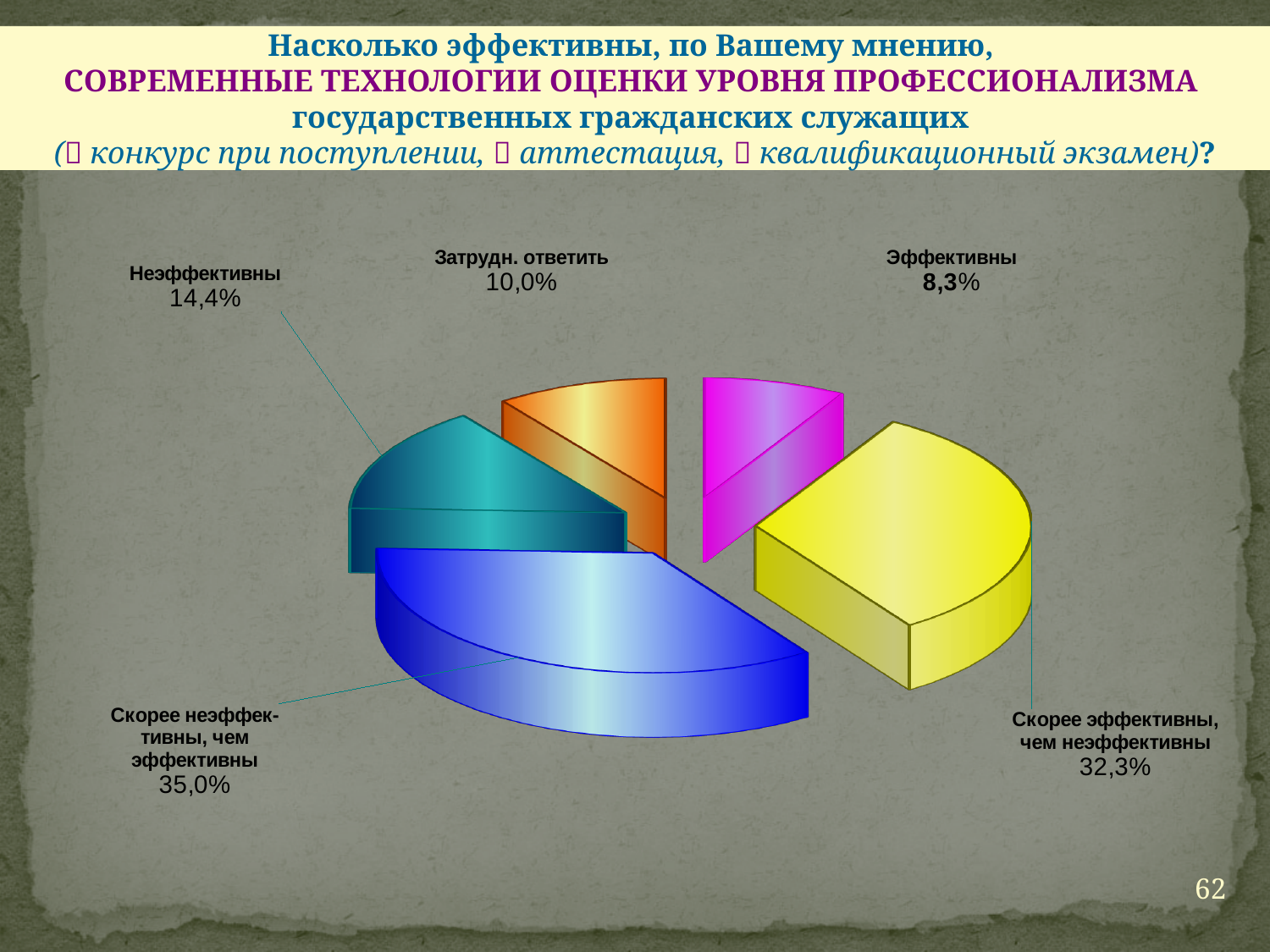
Which answer option has the largest share of the pie? Скорее неэффективны, чем эффективны What share of respondents answered "Неэффективны"? 14,4% How many slices does the pie chart have? 5 What share of respondents answered "Затрудн. ответить"? 10,0% What share of respondents answered "Скорее эффективны, чем неэффективны"? 32,3% Which is larger: the share for "Неэффективны" or the share for "Затрудн. ответить"? Неэффективны What share of respondents answered "Эффективны"? 8,3% What colour is the slice for "Скорее эффективны, чем неэффективны"? yellow What kind of chart is shown on the slide? pie chart What share of respondents answered "Скорее неэффективны, чем эффективны"? 35,0% What is the difference in percentage points between "Скорее неэффективны, чем эффективны" and "Скорее эффективны, чем неэффективны"? 2,7 Which answer option has the smallest share of the pie? Эффективны